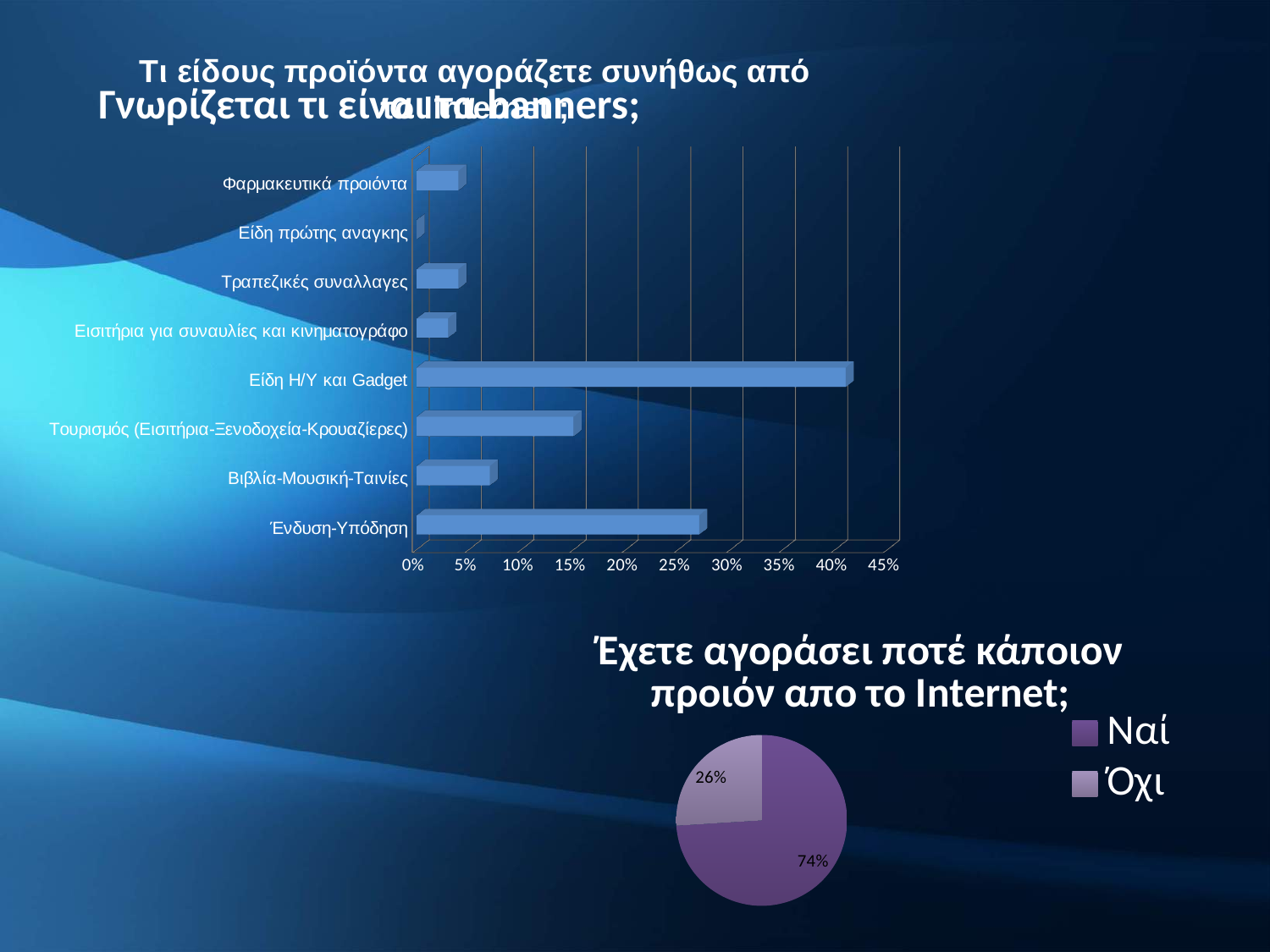
In the bar chart at the top of the slide, how many categories are shown? 8 In the bar chart at the top of the slide, which is larger: Ένδυση-Υπόδηση or Βιβλία-Μουσική-Ταινίες? Ένδυση-Υπόδηση In the bar chart at the top of the slide, is the value for Τουρισμός (Εισιτήρια-Ξενοδοχεία-Κρουαζίερες) greater or less than 20%? less What kind of chart is the chart at the top of the slide? bar chart How many entries does the legend of the pie chart 'Έχετε αγοράσει ποτέ κάποιον προιόν απο το Internet;' list? 2 In the pie chart 'Έχετε αγοράσει ποτέ κάποιον προιόν απο το Internet;', what is the difference between the Ναί and Όχι shares? 48% In the bar chart at the top of the slide, is the value for Ένδυση-Υπόδηση greater or less than 20%? greater In the bar chart at the top of the slide, is the value for Είδη Η/Υ και Gadget greater or less than 35%? greater In the pie chart 'Έχετε αγοράσει ποτέ κάποιον προιόν απο το Internet;', what share is Όχι? 26% In the bar chart at the top of the slide, which category has the lowest value? Είδη πρώτης αναγκης In the pie chart 'Έχετε αγοράσει ποτέ κάποιον προιόν απο το Internet;', what share is Ναί? 74% In the bar chart at the top of the slide, which category has the highest value? Είδη Η/Υ και Gadget